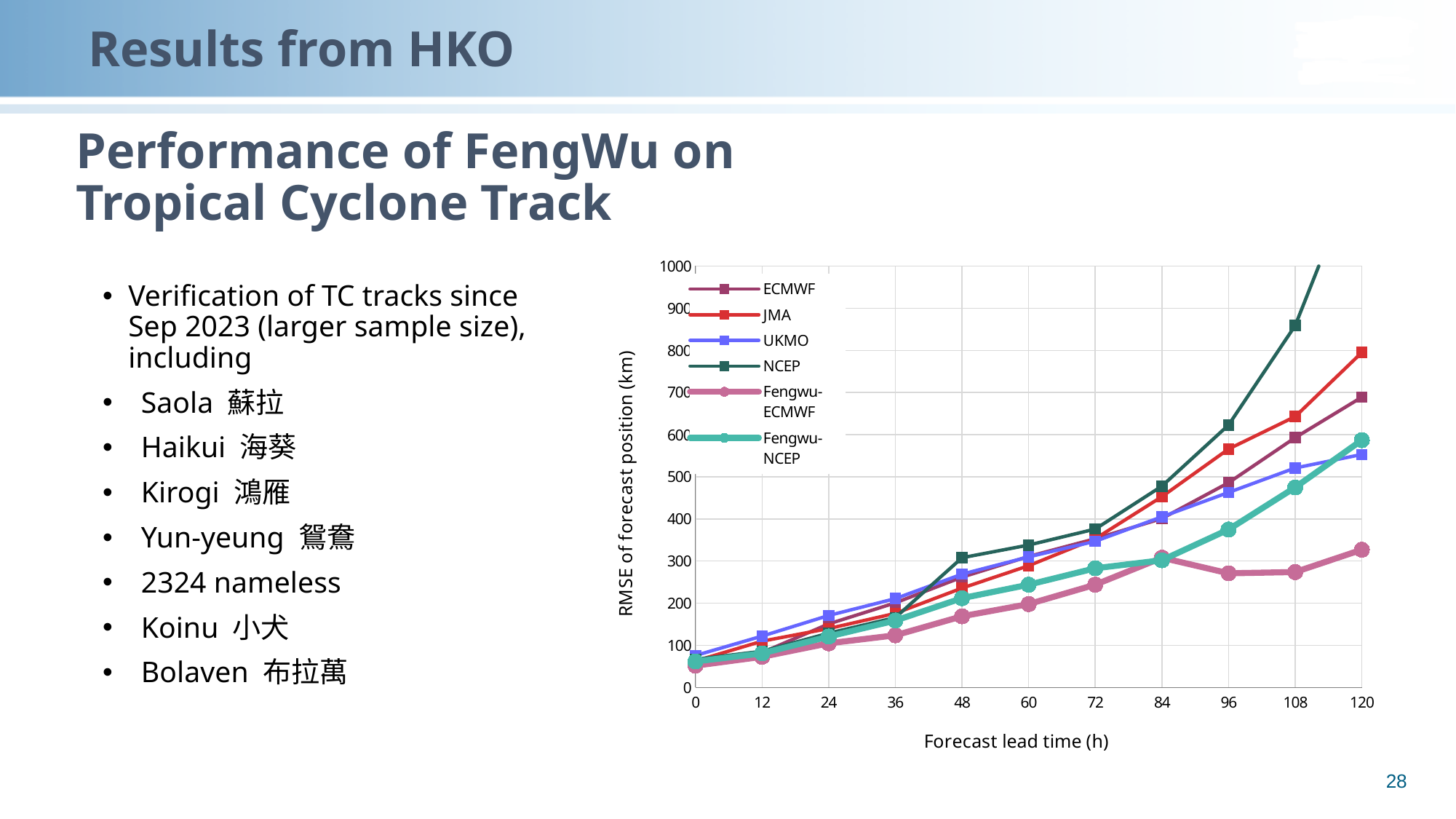
What is the label of the x axis of the chart? Forecast lead time (h) Is the RMSE for Fengwu-ECMWF at 120 h greater or less than 400? less At a forecast lead time of 120 h, which has the larger RMSE, JMA or ECMWF? JMA At a forecast lead time of 120 h, which has the larger RMSE, UKMO or Fengwu-ECMWF? UKMO How many series does the chart legend list? 6 What is the label of the y axis of the chart? RMSE of forecast position (km) Which series has the highest RMSE at a forecast lead time of 108 h? NCEP What kind of chart is shown on the slide? line chart Is the RMSE for JMA at 120 h greater or less than 700? greater Which series has the lowest RMSE at a forecast lead time of 120 h? Fengwu-ECMWF Is the RMSE for NCEP at 108 h greater or less than 800? greater How many forecast lead times are marked on the x axis of the chart? 11